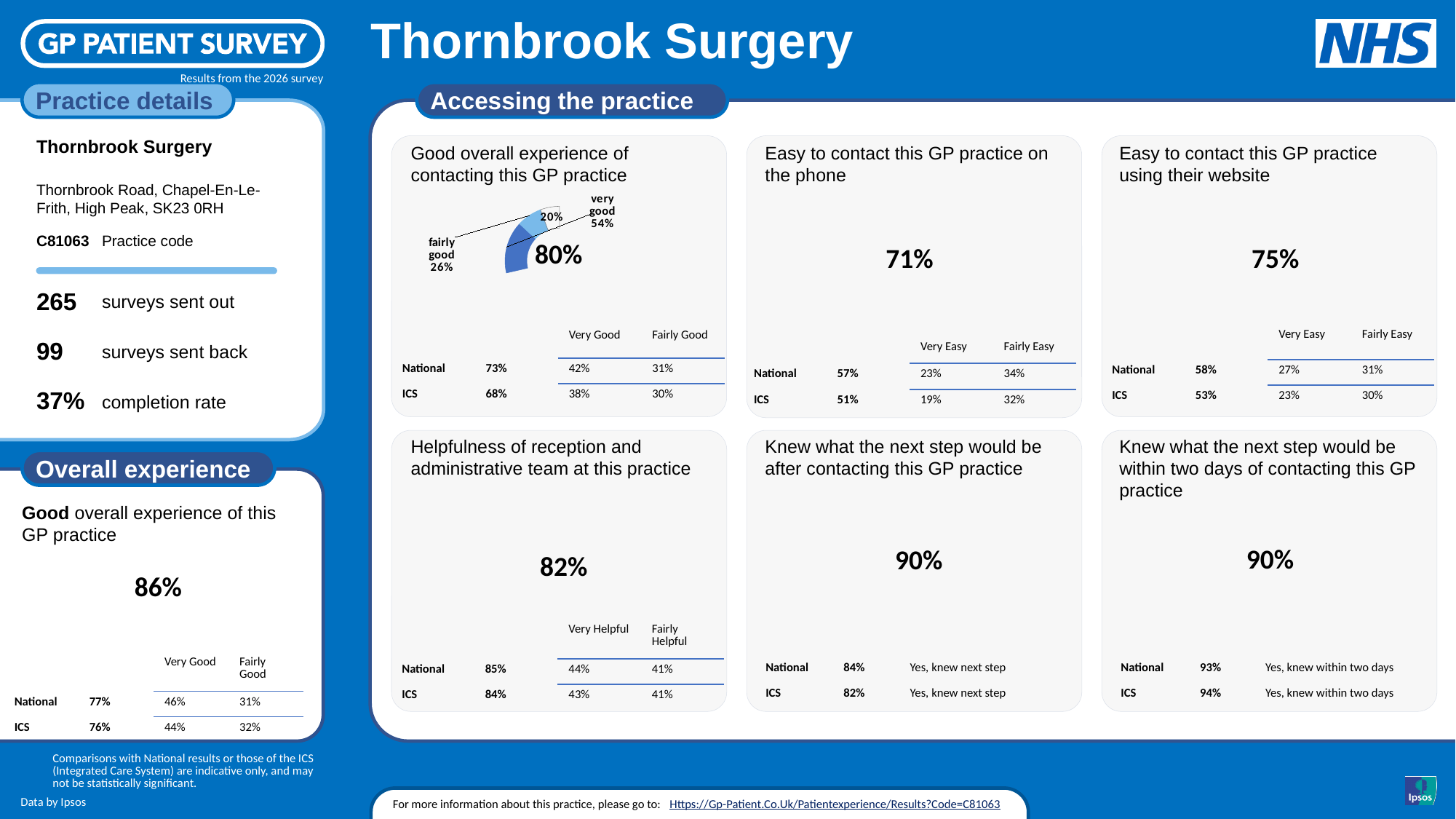
How many segments are shown in the 'Good overall experience of contacting this GP practice' chart? 3 What is the difference between the 'very good' and 'fairly good' percentages in the 'Good overall experience of contacting this GP practice' chart? 28% Is the 'very good' percentage in the 'Good overall experience of contacting this GP practice' chart greater or less than 50%? greater Which section of the slide contains the 'Good overall experience of contacting this GP practice' chart? Accessing the practice In the 'Good overall experience of contacting this GP practice' chart, what percentage is shown for the segment without a category name? 20% What is the combined percentage of 'very good' and 'fairly good' in the 'Good overall experience of contacting this GP practice' chart? 80% Which labelled segment is larger in the 'Good overall experience of contacting this GP practice' chart: 'very good' or 'fairly good'? very good In the 'Good overall experience of contacting this GP practice' chart, what percentage is labelled 'very good'? 54% What is the large figure shown in the centre of the 'Good overall experience of contacting this GP practice' chart? 80% Which segment has the highest percentage in the 'Good overall experience of contacting this GP practice' chart? very good What kind of chart is used for 'Good overall experience of contacting this GP practice'? pie (doughnut) chart In the 'Good overall experience of contacting this GP practice' chart, what percentage is labelled 'fairly good'? 26%